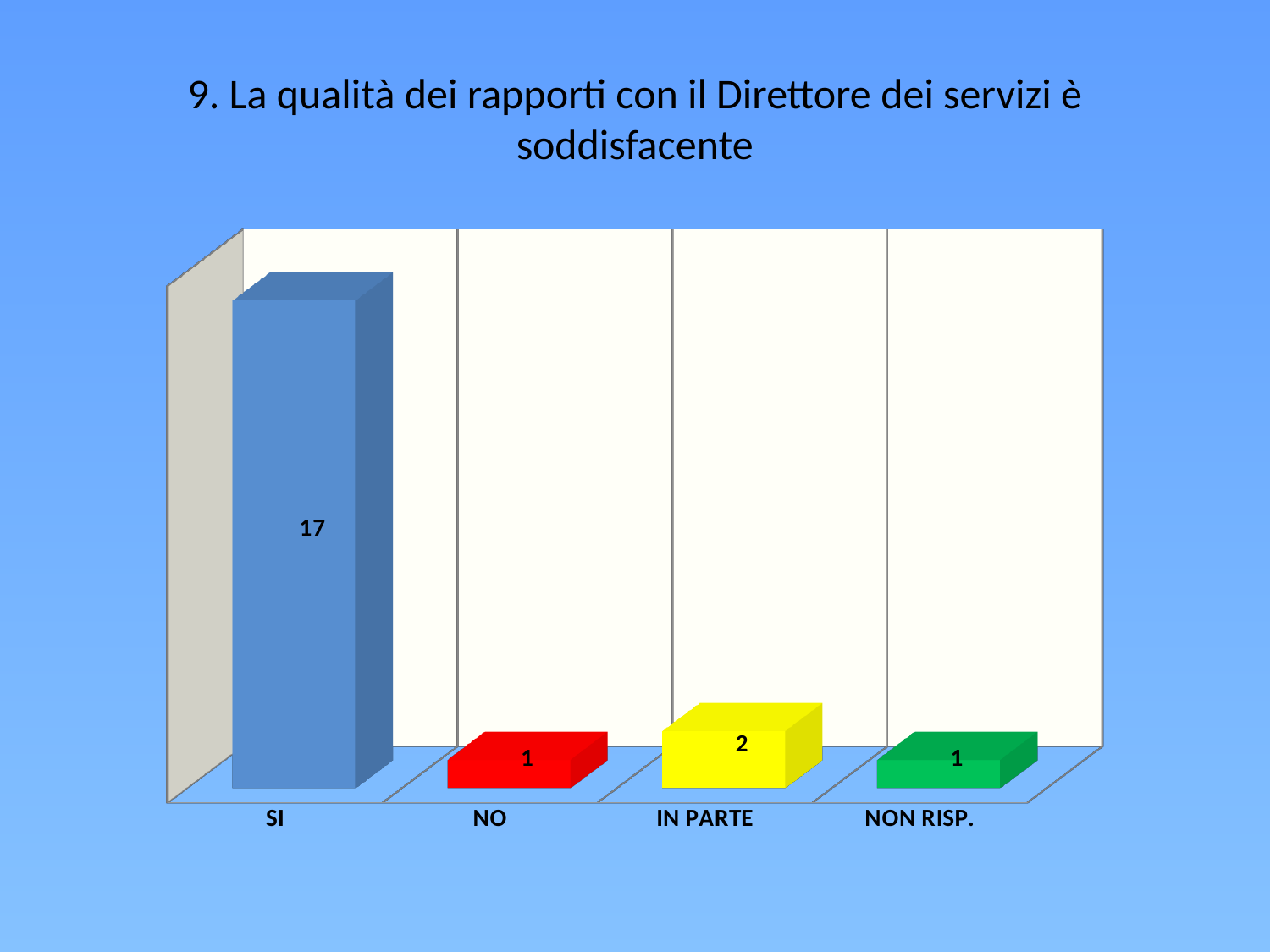
What is the difference between the values for IN PARTE and NO? 1 How many categories are shown on the x axis? 4 What is the total of all the values shown in the chart? 21 What is the value for NO? 1 What is the value for IN PARTE? 2 Which category has the highest value? SI What is the difference between the values for SI and IN PARTE? 15 What colour is the bar for IN PARTE? yellow What is the value for SI? 17 What kind of chart is shown on the slide? bar chart What is the value for NON RISP.? 1 Which is larger, the value for IN PARTE or the value for NON RISP.? IN PARTE